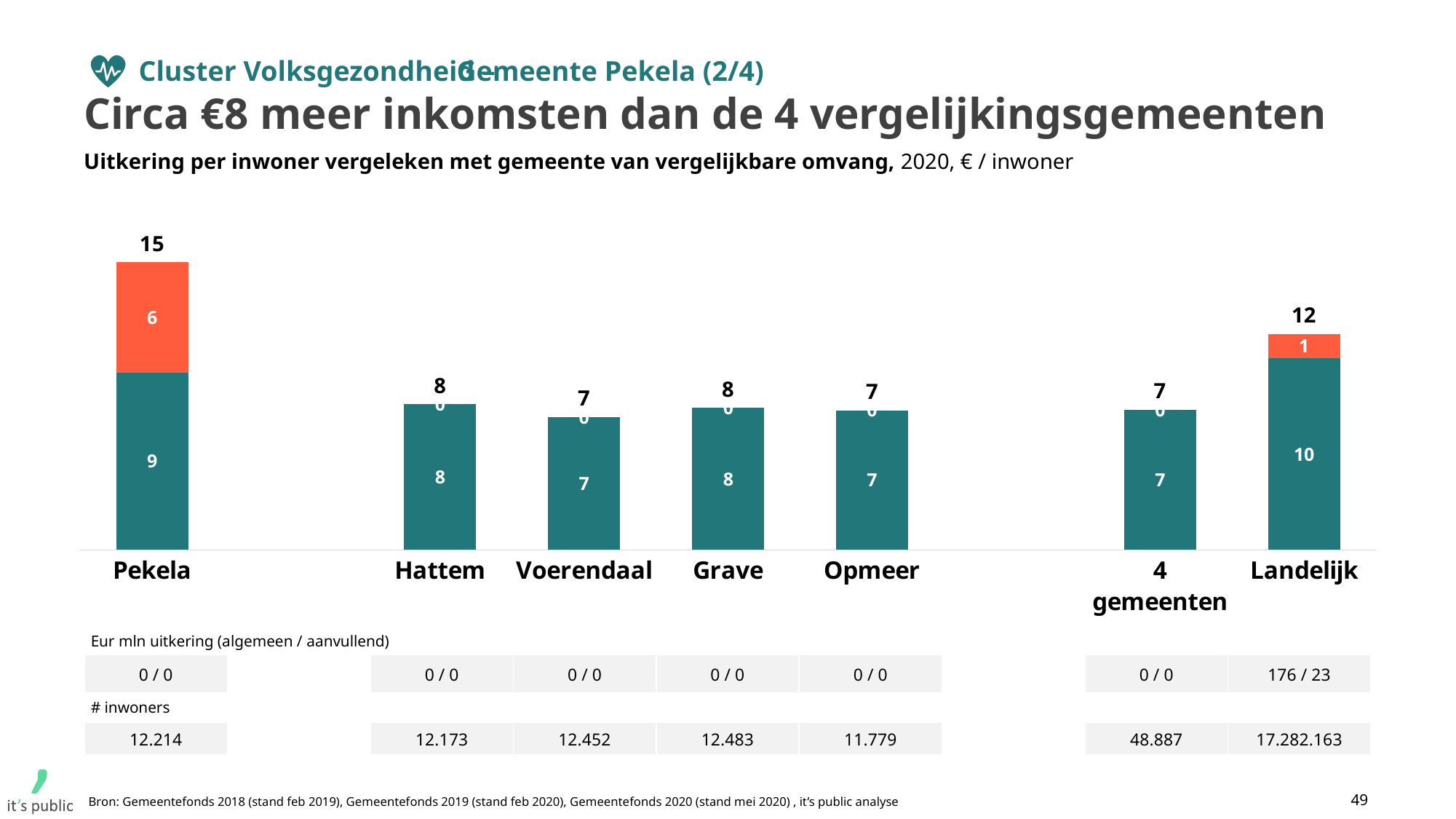
What is the total value shown above the bar for Landelijk? 12 What is the difference between the total for Pekela and the total for 4 gemeenten? 8 Which category has the highest total value? Pekela How many categories are shown on the x axis of the chart? 7 What is the value of the teal (bottom) segment of the Landelijk bar? 10 What kind of chart is shown on the slide? Stacked bar chart Which has a larger total value, Landelijk or Hattem? Landelijk What is the total value shown above the bar for Voerendaal? 7 What is the difference between the total for Grave and the total for Opmeer? 1 What is the number of inwoners listed below the chart for Pekela? 12.214 What is the total value shown above the bar for Pekela? 15 What is the value of the orange (top) segment of the Pekela bar? 6